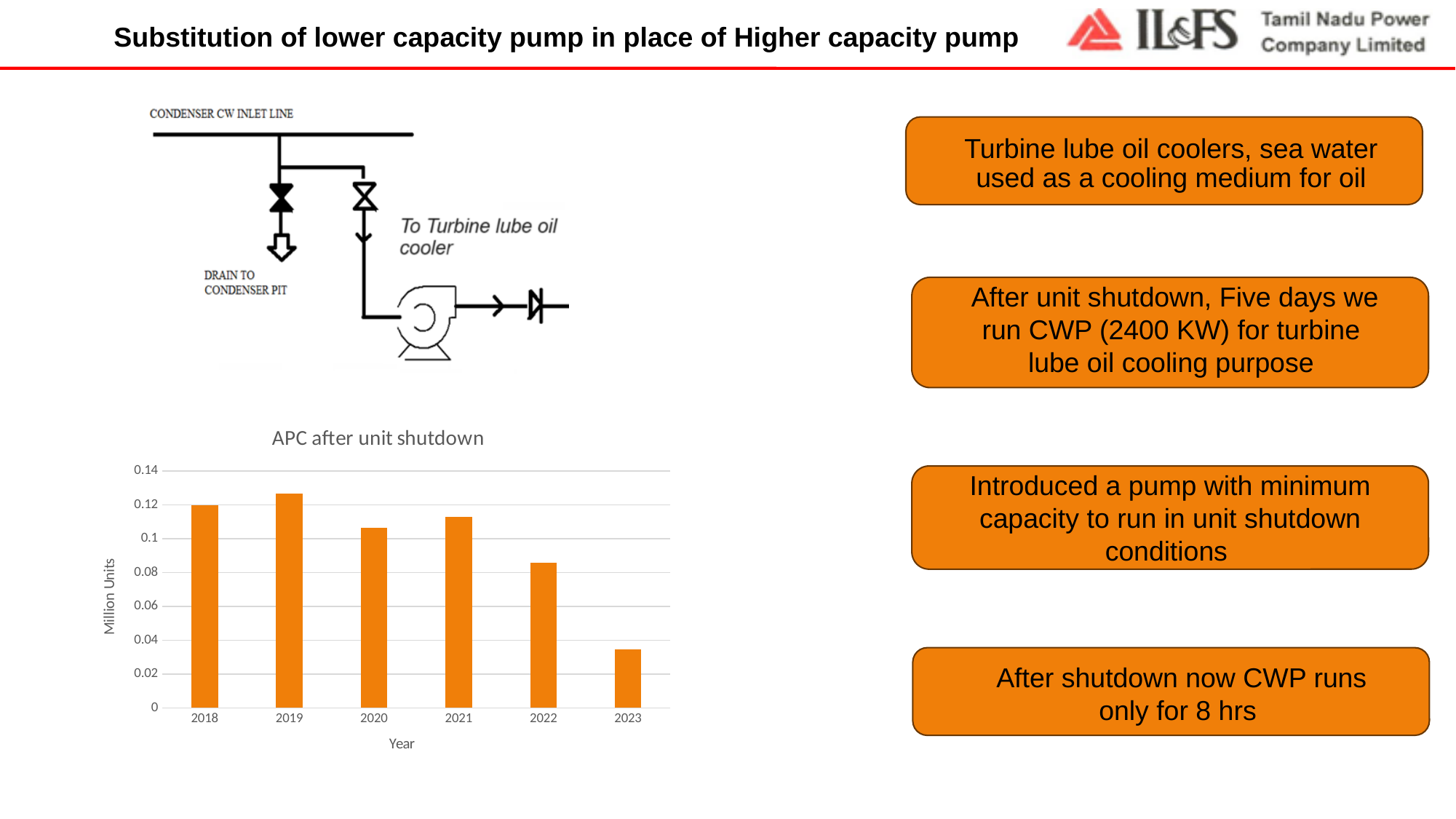
Which year has the larger value, 2021 or 2022? 2021 Is the value for 2019 greater or less than 0.12? greater What kind of chart is shown on the slide? bar chart Do the values generally rise or fall from 2018 to 2023? fall Is the value for 2020 greater or less than 0.1? greater How many years are plotted in the chart? 6 What is the label on the vertical axis of the chart? Million Units Is the value for 2022 greater or less than 0.08? greater What is the title of the chart? APC after unit shutdown Which year has the lowest value in the chart? 2023 Which year has the highest value in the chart? 2019